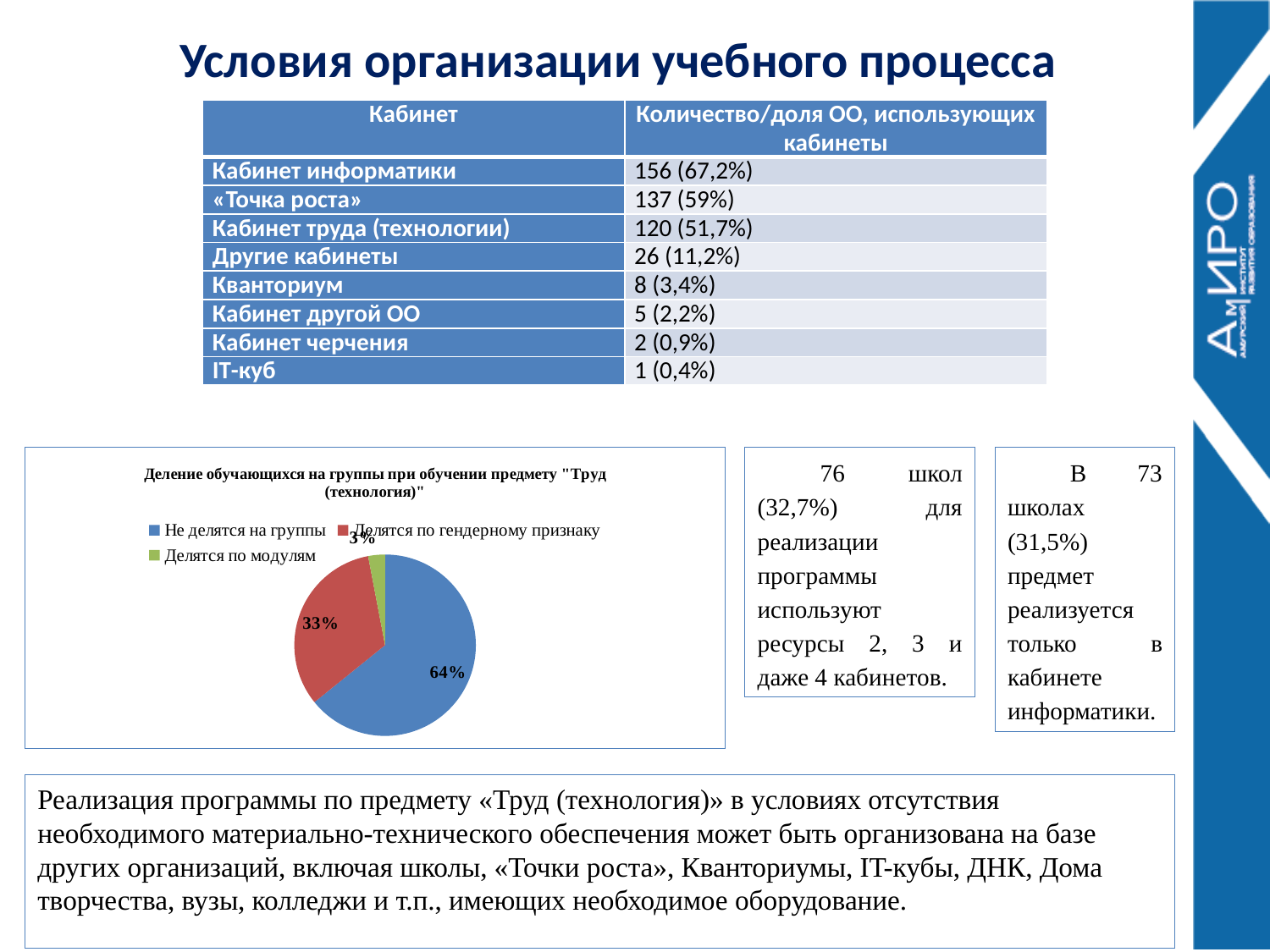
What is the difference in percentage points between "Не делятся на группы" and "Делятся по гендерному признаку"? 31 What colour is the slice for "Делятся по модулям" in the pie chart? green Which is larger: the slice for "Делятся по гендерному признаку" or the slice for "Делятся по модулям"? Делятся по гендерному признаку Which category has the largest slice of the pie? Не делятся на группы What share of the pie does "Делятся по гендерному признаку" have? 33% What share of the pie does "Не делятся на группы" have? 64% What share of the pie does "Делятся по модулям" have? 3% How many entries does the legend of the pie chart list? 3 How many slices does the pie chart have? 3 What is the title of the pie chart? Деление обучающихся на группы при обучении предмету "Труд (технология)" Which category has the smallest slice of the pie? Делятся по модулям What kind of chart is shown on the slide? pie chart